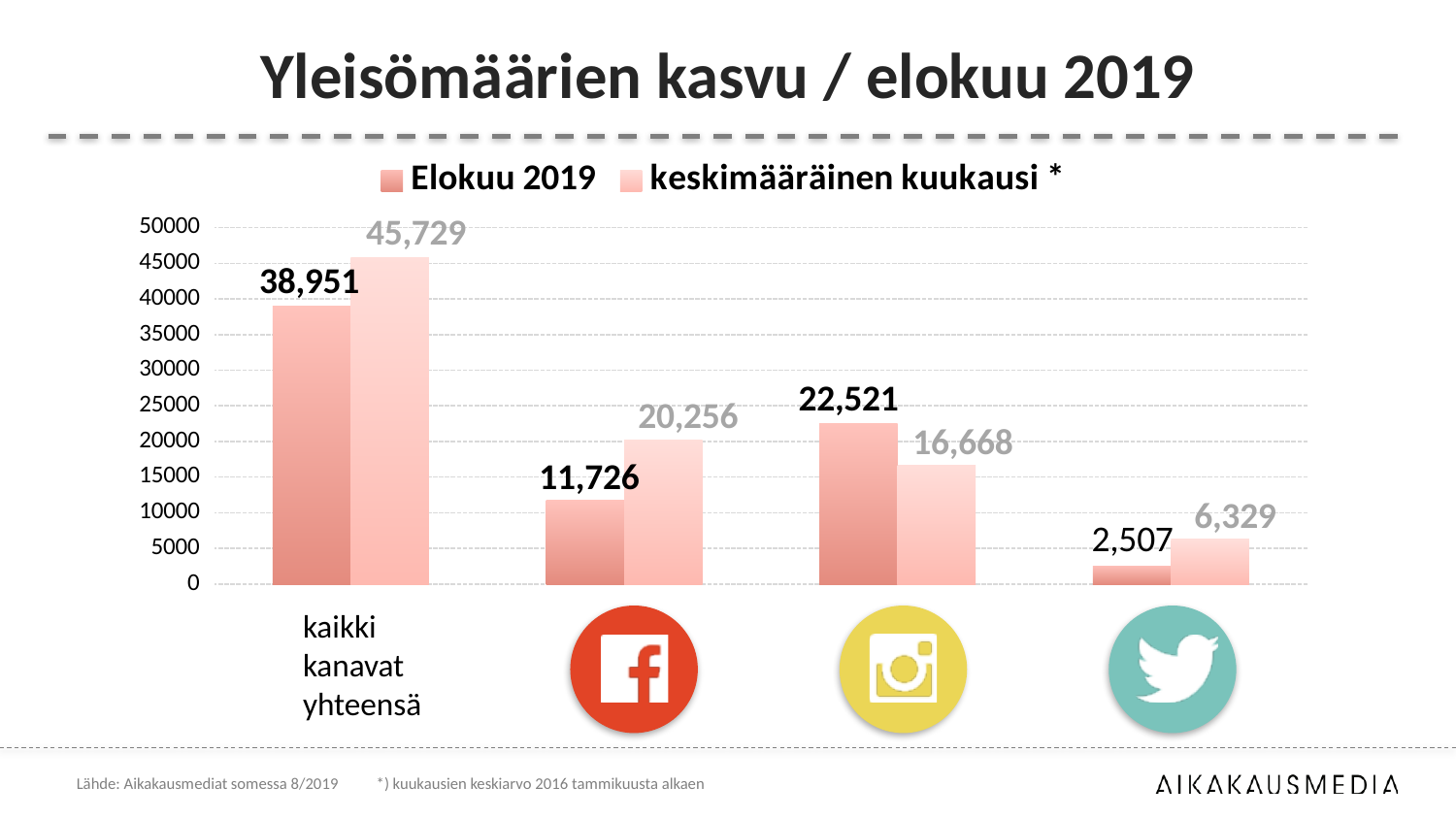
What is the value for Elokuu 2019 for kaikki kanavat yhteensä? 38,951 What is the difference between the keskimääräinen kuukausi value and the Elokuu 2019 value for the Facebook category? 8,530 What is the keskimääräinen kuukausi value for the Instagram category? 16,668 Among the individual channels (Facebook, Instagram, Twitter), which has the highest Elokuu 2019 value? Instagram What kind of chart is shown on the slide? Bar chart What is the keskimääräinen kuukausi value for kaikki kanavat yhteensä? 45,729 What is the Elokuu 2019 value for the Facebook category? 11,726 How many categories are shown on the x axis? 4 Which category has the lowest Elokuu 2019 value? Twitter For the Instagram category, which is larger: the Elokuu 2019 value or the keskimääräinen kuukausi value? Elokuu 2019 What is the Elokuu 2019 value for the Twitter category? 2,507 How many series does the legend list? 2